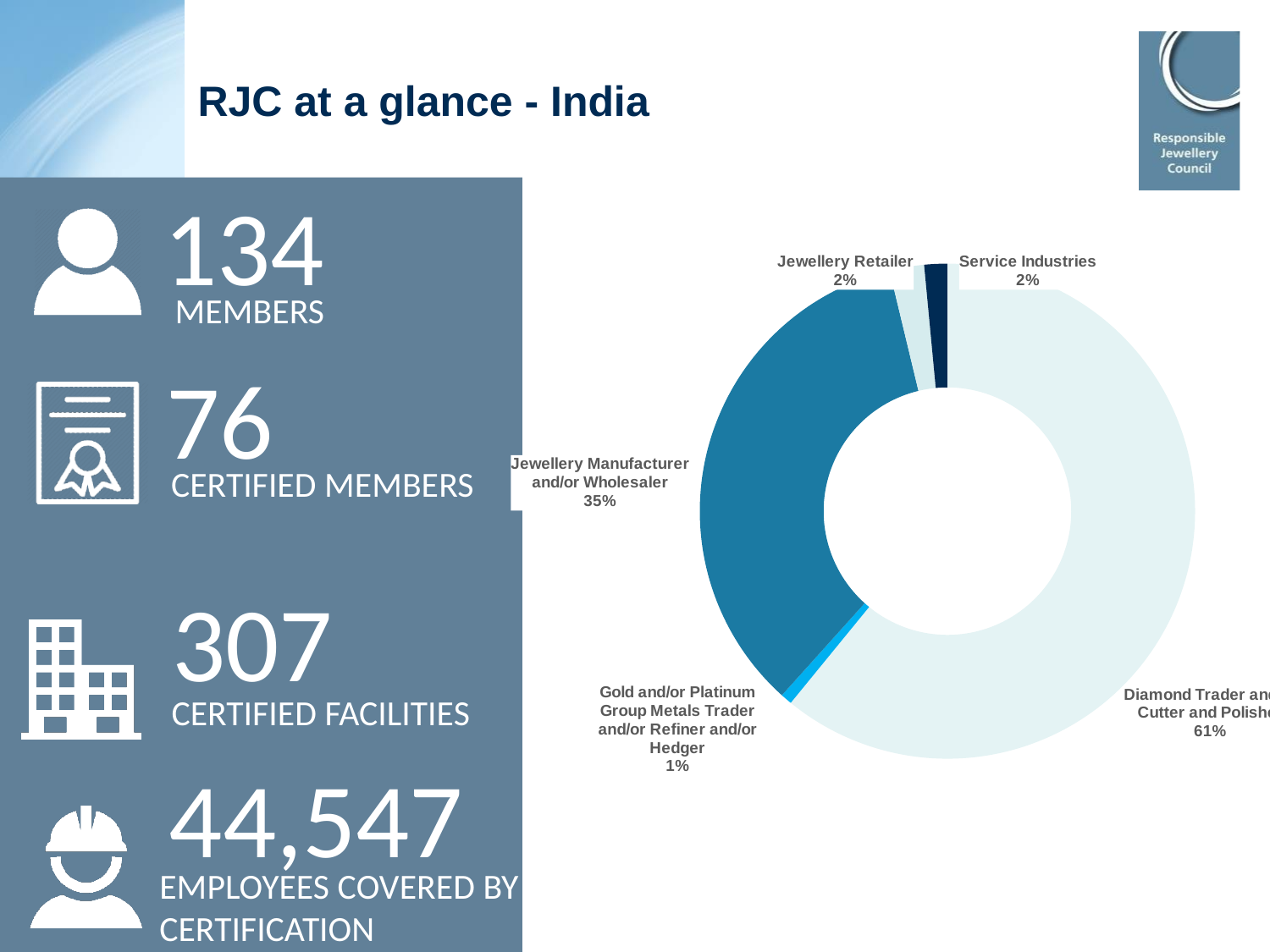
What is the difference in percentage points between the Diamond Trader segment and Jewellery Manufacturer and/or Wholesaler? 26 What is the combined share of Jewellery Retailer and Service Industries? 4% What percentage is shown for Service Industries? 2% What percentage is shown for the Diamond Trader segment? 61% What percentage does the Jewellery Retailer segment represent? 2% Which segment has the smallest share of the donut chart? Gold and/or Platinum Group Metals Trader and/or Refiner and/or Hedger What share is shown for Gold and/or Platinum Group Metals Trader and/or Refiner and/or Hedger? 1% What share of the donut chart is Jewellery Manufacturer and/or Wholesaler? 35% What type of chart is shown on the slide? Donut (pie) chart Which segment has the largest share of the donut chart? Diamond Trader and/or Cutter and Polisher Which is larger: Jewellery Manufacturer and/or Wholesaler or Jewellery Retailer? Jewellery Manufacturer and/or Wholesaler How many segments does the donut chart have? 5